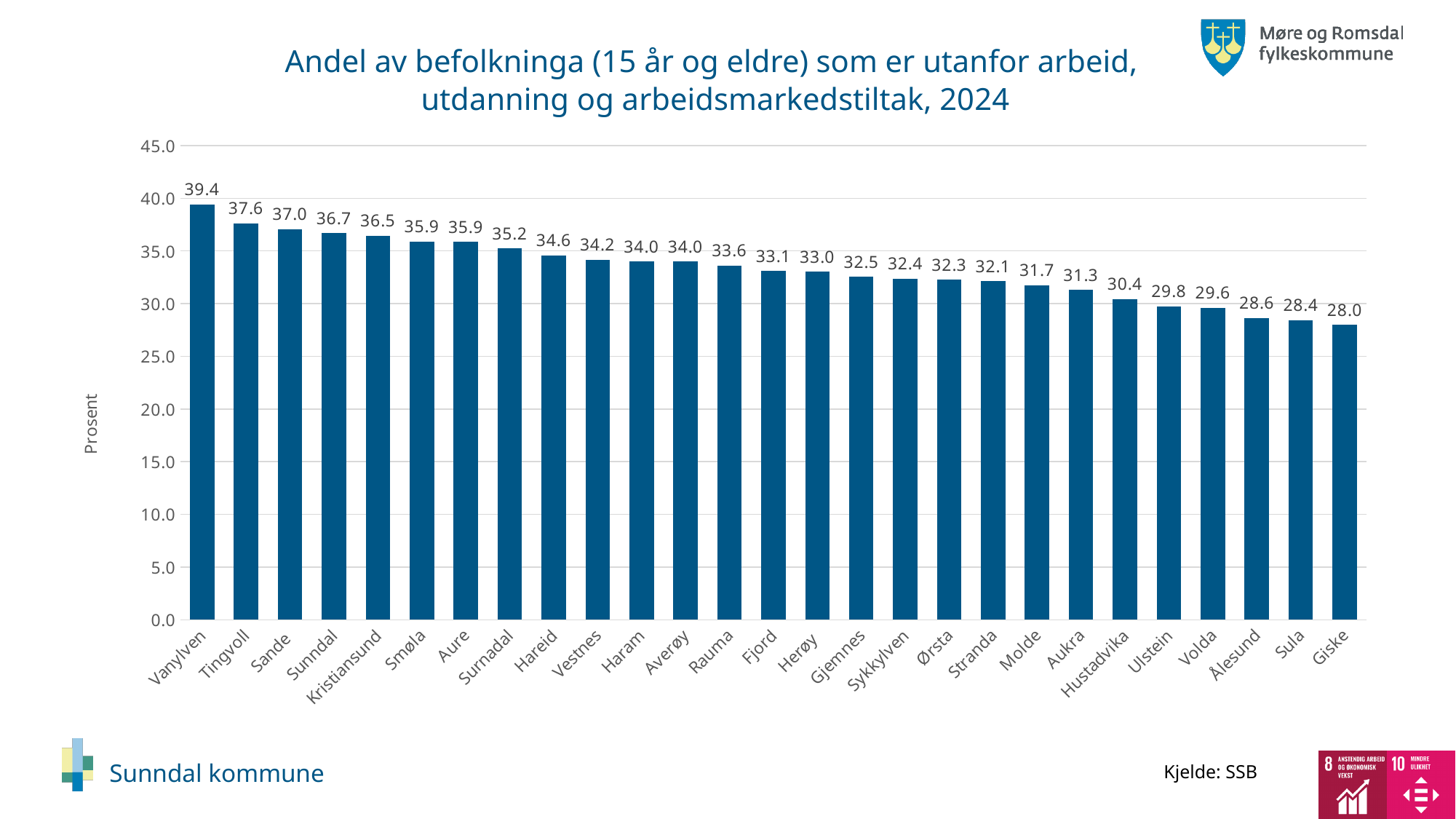
What is the label on the vertical axis? Prosent What is the difference between the values for Sunndal and Molde? 5.0 Which municipality has the lowest value? Giske What is the difference between the values for Vanylven and Giske? 11.4 Is the value for Hustadvika greater or less than 35.0? less What is the value for Giske? 28.0 What is the value for Molde? 31.7 How many municipalities are shown in the chart? 27 Which municipality has the highest value? Vanylven What is the value for Sunndal? 36.7 What kind of chart is shown on the slide? bar chart Which has a larger value, Kristiansund or Ålesund? Kristiansund